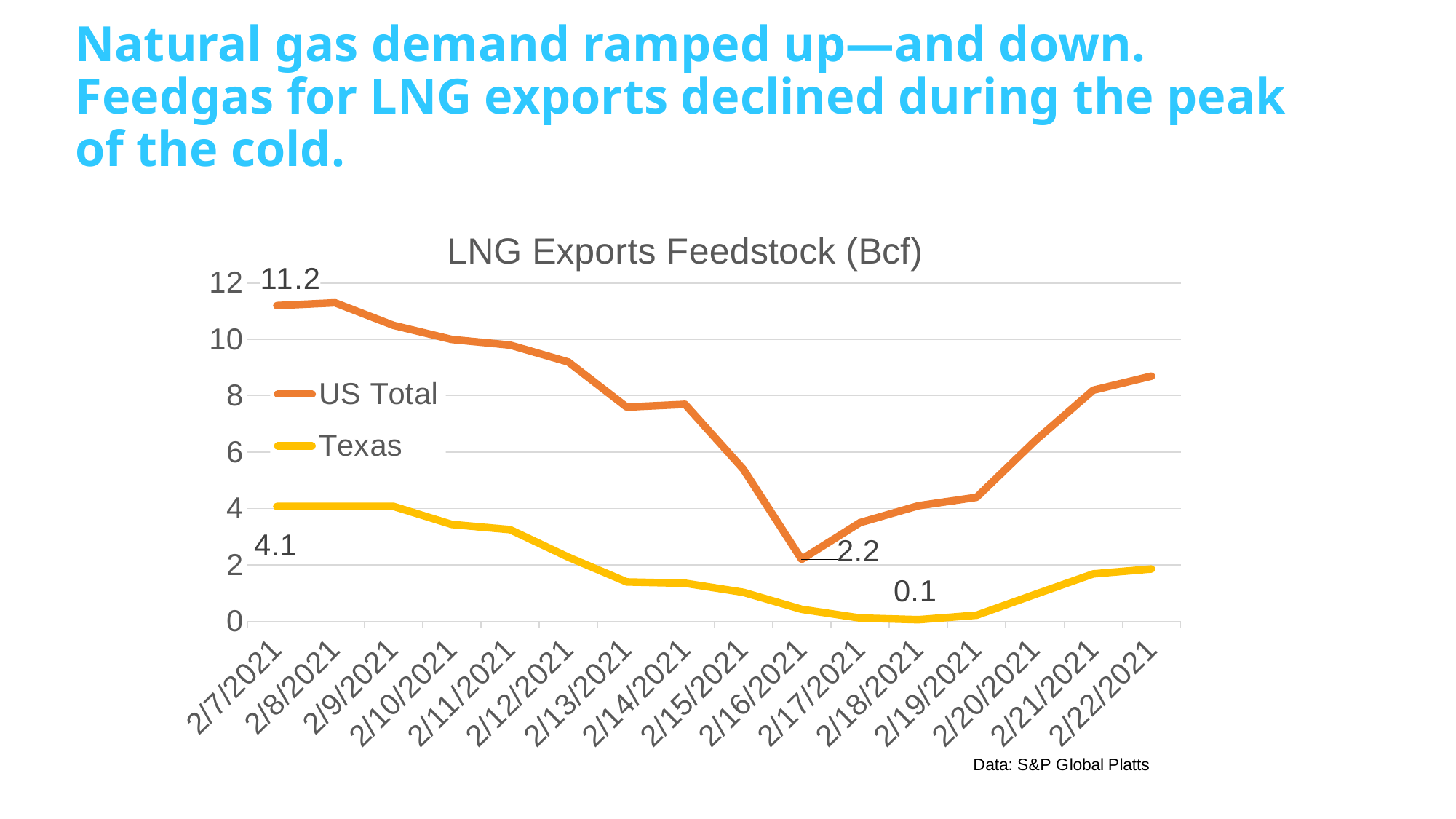
By how much did the US Total fall from 2/7/2021 to 2/16/2021? 9 What is the US Total value on 2/16/2021? 2.2 What is the Texas value on 2/7/2021? 4.1 On which date is the US Total at its lowest? 2/16/2021 How many series does the legend list? 2 Is the US Total value on 2/22/2021 greater or less than 8? greater What kind of chart is shown on the slide? line chart How many dates are shown on the x axis? 16 What is the US Total value on 2/7/2021? 11.2 What is the Texas value on 2/18/2021? 0.1 By how much did the Texas value fall from 2/7/2021 to 2/18/2021? 4 What is the title of the chart? LNG Exports Feedstock (Bcf)